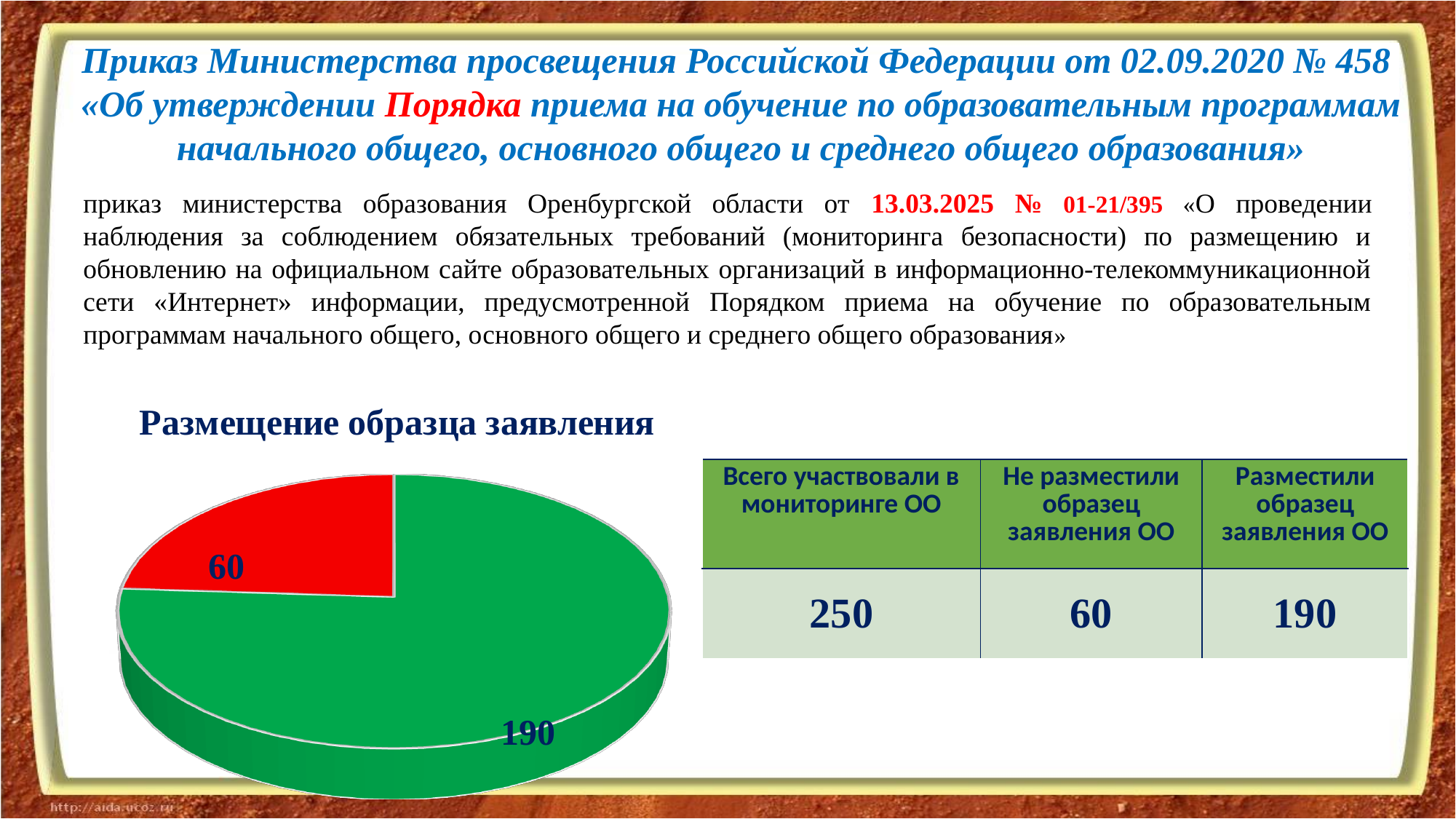
According to the table next to the pie chart, how many organisations did not post the sample application ("Не разместили образец заявления ОО")? 60 What value is labelled on the red slice of the pie chart? 60 How many slices does the pie chart have? 2 What share of the pie does the red slice (60) represent? 24% What is the title of the pie chart? Размещение образца заявления What is the difference between the values of the green slice and the red slice in the pie chart? 130 What share of the pie does the green slice (190) represent? 76% What value is labelled on the green slice of the pie chart? 190 Which slice of the pie chart is larger, the red one or the green one? green Which colour is used for the largest slice of the pie chart? green What kind of chart is shown under the title "Размещение образца заявления"? pie chart What is the total of the two slice values in the pie chart? 250